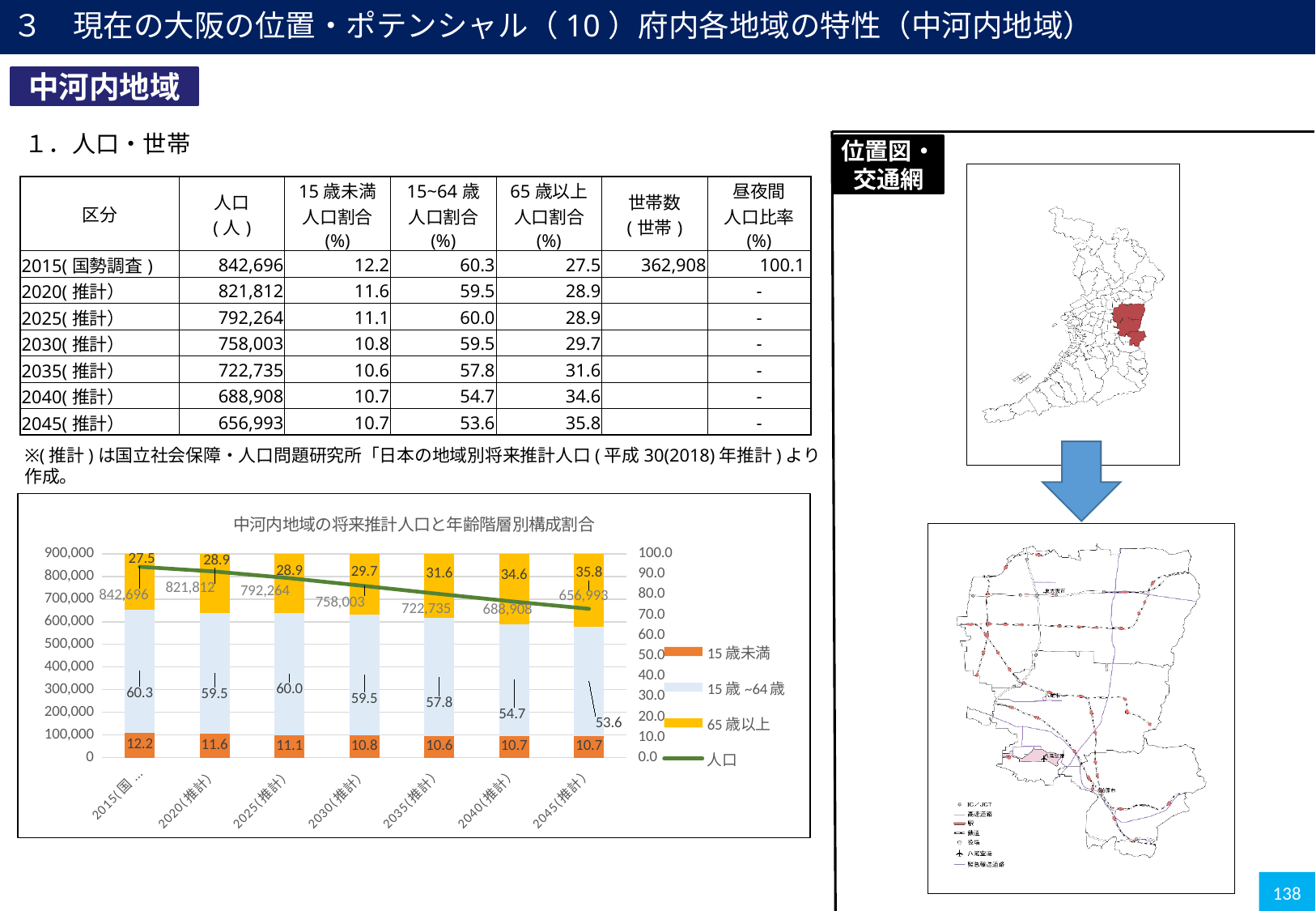
Does the 人口 line rise or fall from 2015 to 2045(推計) in the chart? Fall Which has the larger 15歳~64歳 share in the chart, 2025(推計) or 2040(推計)? 2025(推計) Which category has the lowest 人口 value in the chart? 2045(推計) What is the 15歳未満 share shown for 2015 in the chart? 12.2 What is the 65歳以上 share shown for 2045(推計) in the chart? 35.8 What is the value of the 人口 series for 2030(推計) in the chart? 758,003 How many categories are shown on the x axis of the chart? 7 How many series does the chart's legend list? 4 What is the difference between the 人口 value for 2015 and the 人口 value for 2045(推計) in the chart? 185,703 By how much does the 65歳以上 share for 2045(推計) exceed that for 2015 in the chart? 8.3 What kind of chart is shown on the slide? A stacked bar chart combined with a line chart Which category has the highest 65歳以上 share in the chart? 2045(推計)